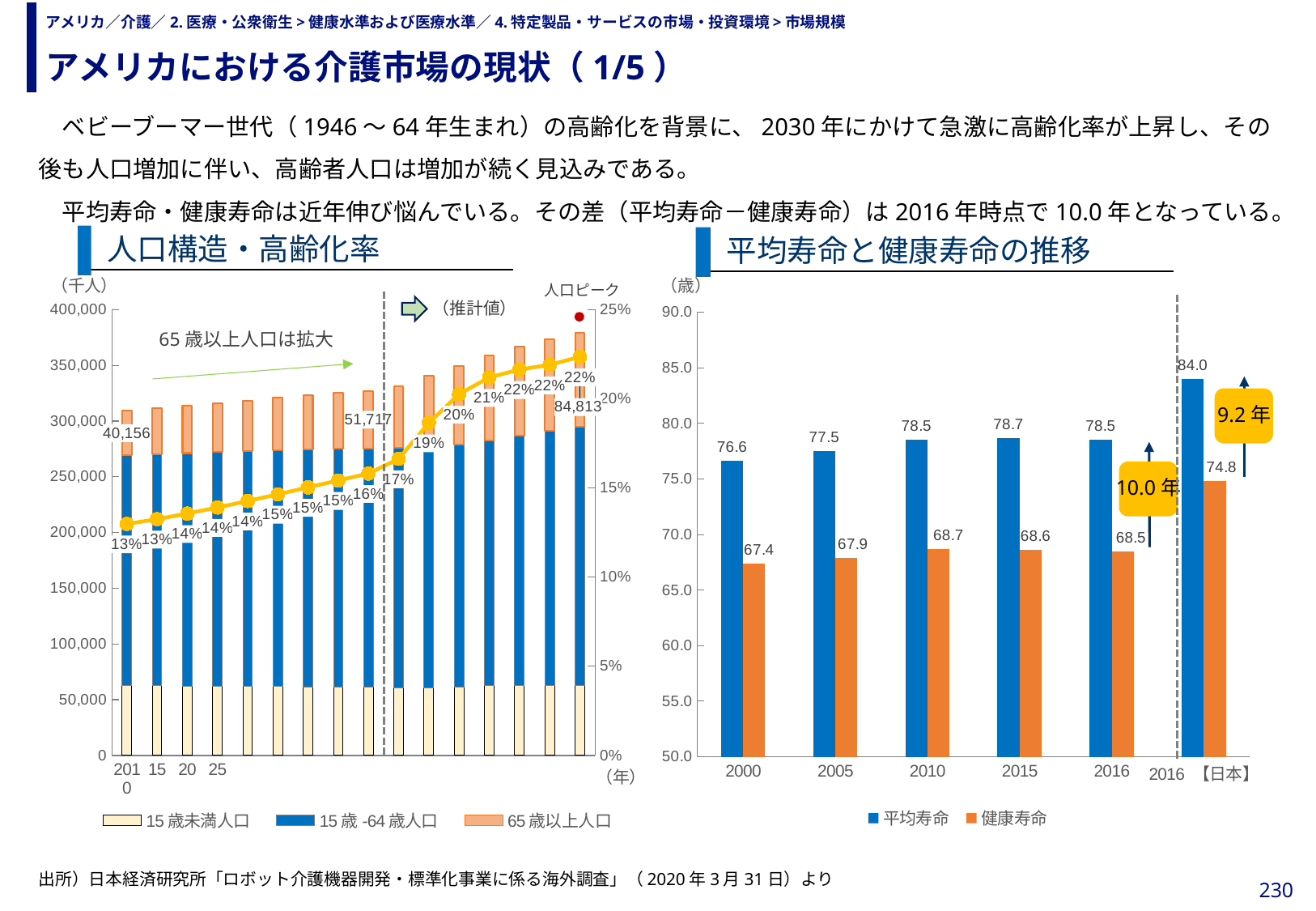
In the chart titled 平均寿命と健康寿命の推移, which is larger, the 平均寿命 for 2005 or for 2015? 2015 In the chart titled 平均寿命と健康寿命の推移, which category has the highest 平均寿命 value? 2016【日本】 In the chart titled 平均寿命と健康寿命の推移, what is the 平均寿命 value for 2016【日本】? 84.0 What kind of chart is the chart titled 平均寿命と健康寿命の推移? bar chart In the chart titled 人口構造・高齢化率, what is the aging-rate percentage shown on the line for 2010? 13% In the chart titled 平均寿命と健康寿命の推移, what is the 健康寿命 value for 2010? 68.7 In the chart titled 人口構造・高齢化率, what is the labelled value of the 65歳以上人口 segment for 2010? 40,156 In the chart titled 平均寿命と健康寿命の推移, what is the difference between 平均寿命 and 健康寿命 for 2016 (the US bars)? 10.0 In the chart titled 平均寿命と健康寿命の推移, what is the 平均寿命 value for 2000? 76.6 In the chart titled 平均寿命と健康寿命の推移, how many series does the legend list? 2 In the chart titled 平均寿命と健康寿命の推移, what is the difference between 平均寿命 and 健康寿命 for 2016【日本】? 9.2 In the chart titled 人口構造・高齢化率, does the aging-rate line rise or fall from left to right? rise